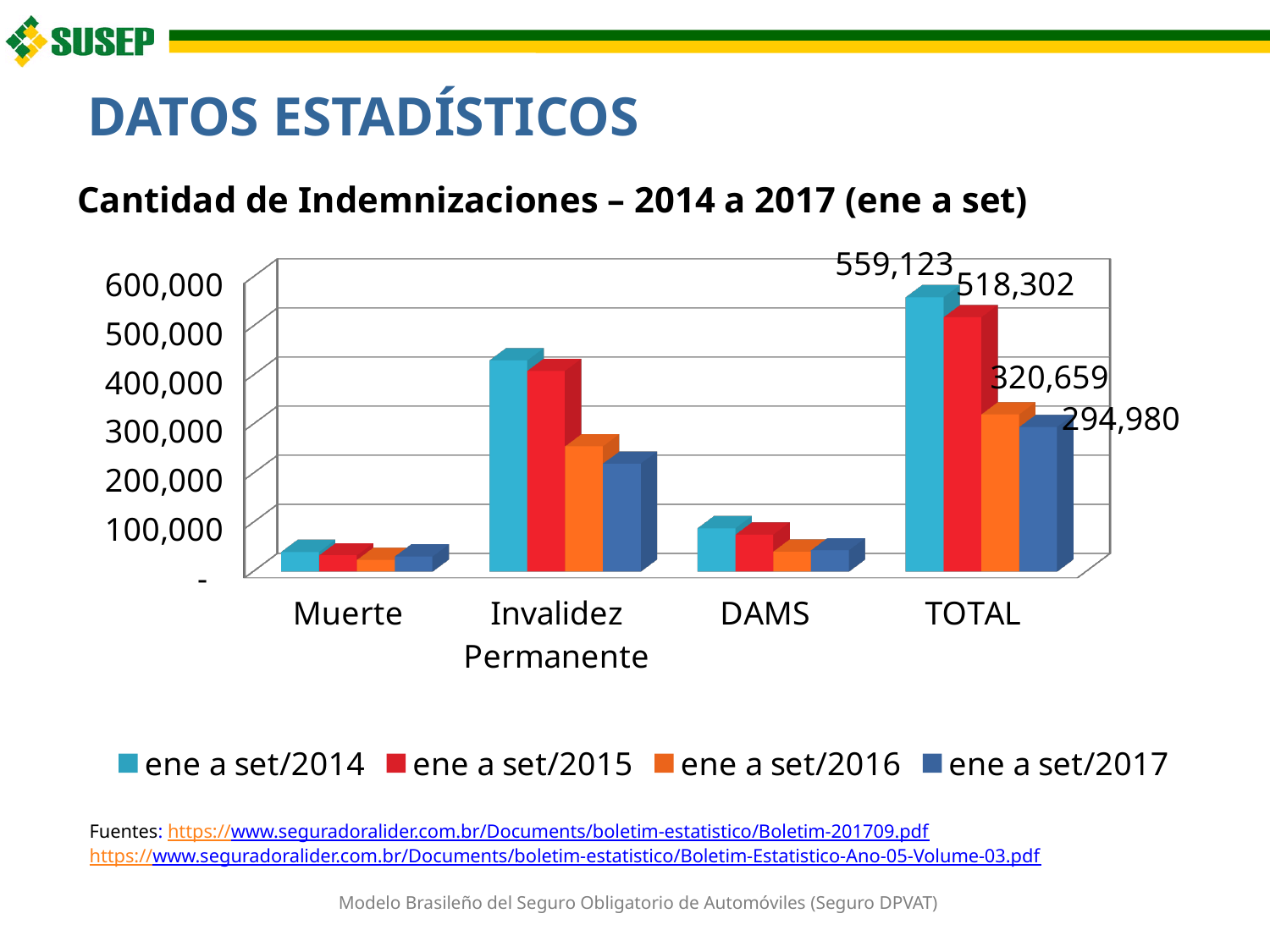
What is the value for TOTAL in the ene a set/2015 series? 518,302 What kind of chart is shown on the slide? bar chart Is the value for Invalidez Permanente in the ene a set/2017 series greater or less than 300,000? less What is the difference between the TOTAL values for ene a set/2014 and ene a set/2015? 40,821 How many categories are shown on the x axis? 4 Which category has the lowest values across all series? Muerte What is the value for TOTAL in the ene a set/2016 series? 320,659 Is the TOTAL value for ene a set/2016 larger or smaller than the TOTAL value for ene a set/2017? larger Which series has the highest TOTAL value? ene a set/2014 What is the value for TOTAL in the ene a set/2014 series? 559,123 What is the value for TOTAL in the ene a set/2017 series? 294,980 How many series does the legend list? 4